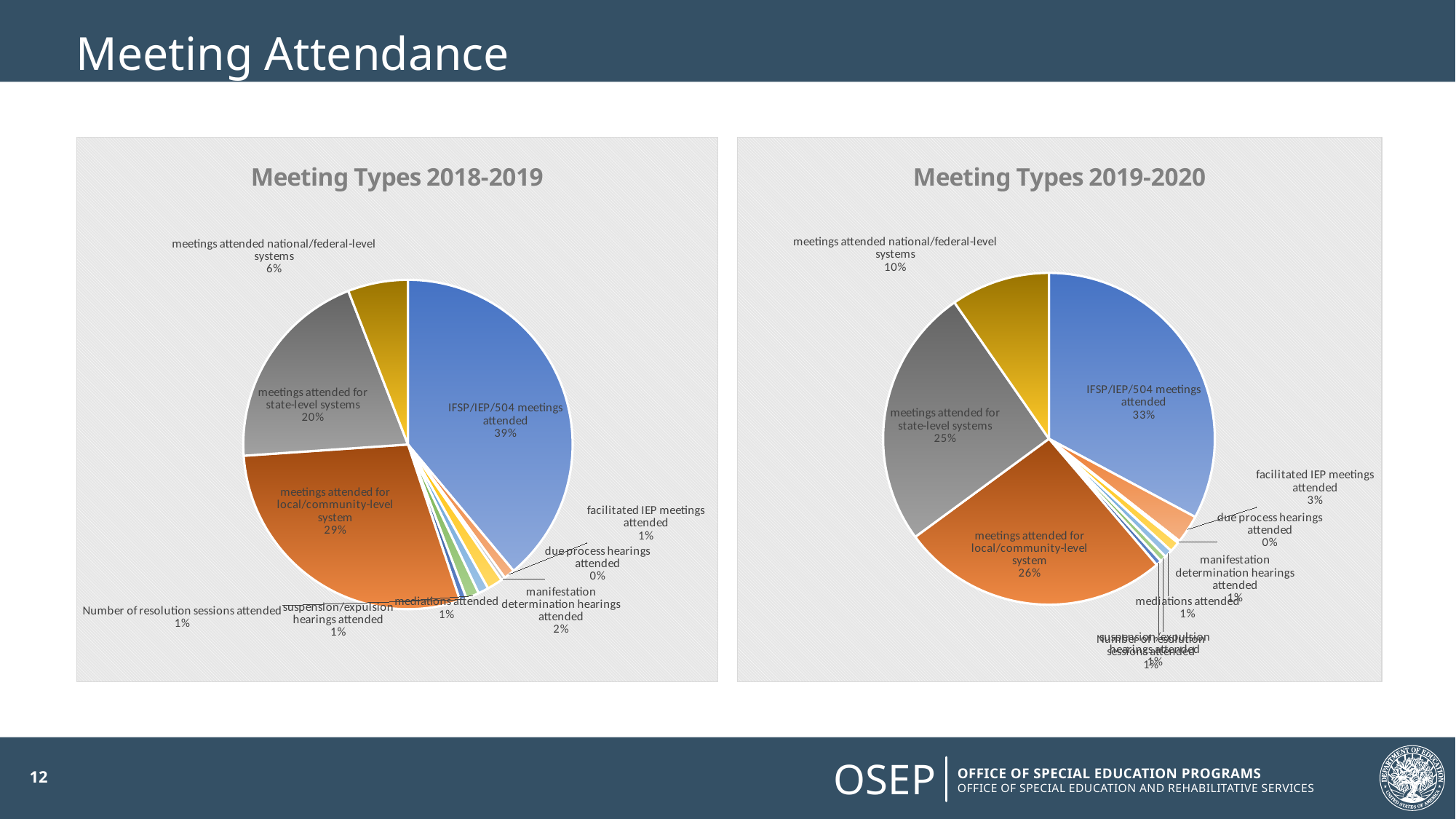
Which chart shows a larger share for meetings attended national/federal-level systems, Meeting Types 2018-2019 or Meeting Types 2019-2020? Meeting Types 2019-2020 What is the title of the chart on the right side of the slide? Meeting Types 2019-2020 In the Meeting Types 2018-2019 chart, what percentage is shown for manifestation determination hearings attended? 2% In the Meeting Types 2019-2020 chart, what is the difference in percentage points between IFSP/IEP/504 meetings attended and meetings attended for local/community-level system? 7 In the Meeting Types 2019-2020 chart, what percentage is shown for meetings attended national/federal-level systems? 10% In the Meeting Types 2019-2020 chart, what share of meetings were meetings attended for state-level systems? 25% In the Meeting Types 2018-2019 chart, what is the difference in percentage points between meetings attended for local/community-level system and meetings attended for state-level systems? 9 In the Meeting Types 2018-2019 chart, what share of meetings were IFSP/IEP/504 meetings attended? 39% In the Meeting Types 2018-2019 chart, which meeting type has the largest share? IFSP/IEP/504 meetings attended What kind of chart is the Meeting Types 2018-2019 chart? Pie chart In the Meeting Types 2019-2020 chart, which meeting type has the largest share? IFSP/IEP/504 meetings attended In the Meeting Types 2018-2019 chart, which meeting type has the smallest share? due process hearings attended